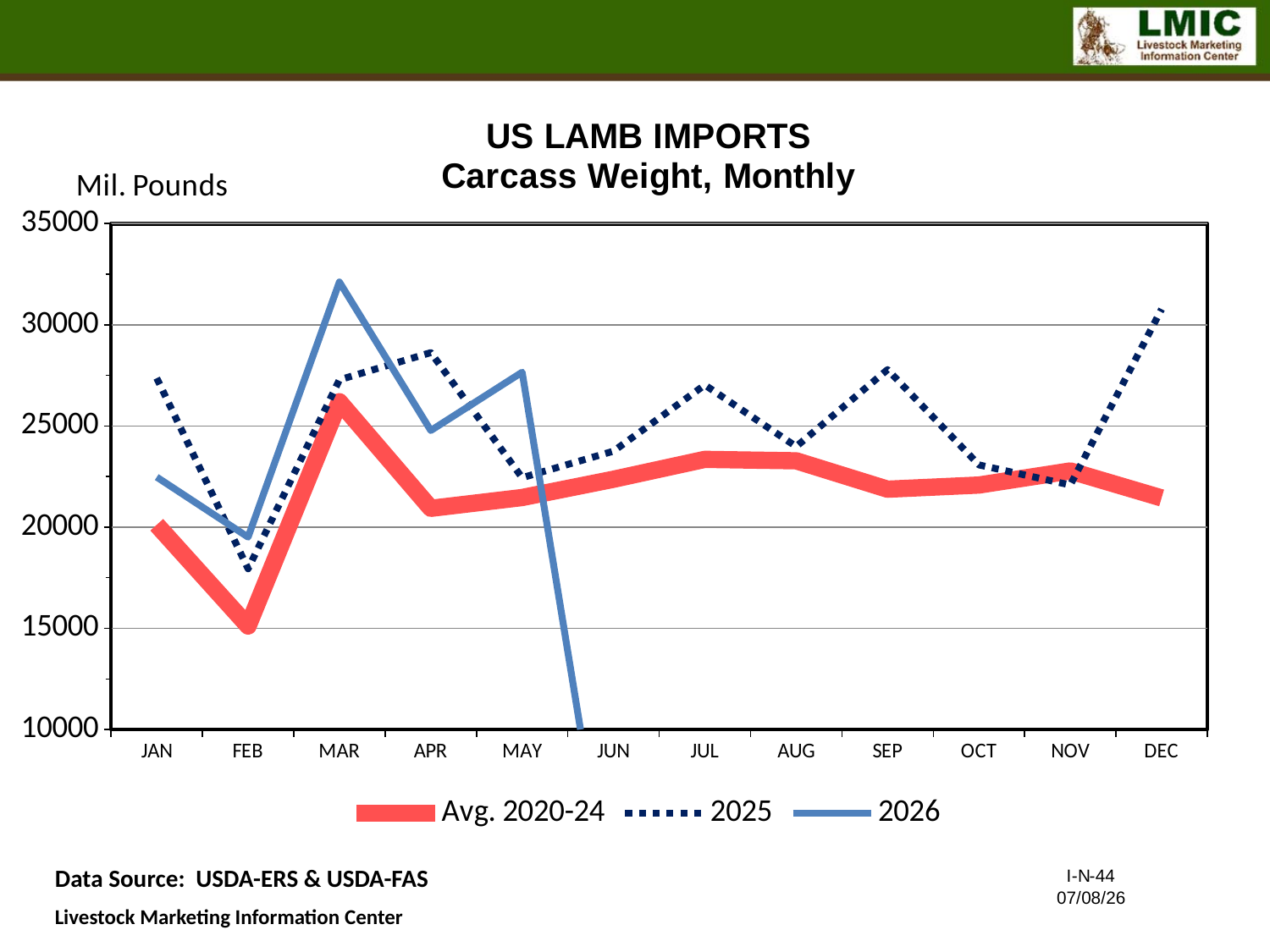
Does the Avg. 2020-24 series rise or fall from JAN to FEB? fall Is the value for Avg. 2020-24 in FEB greater or less than 20000? less Is the value for 2025 in FEB greater or less than 20000? less Is the value for 2026 in MAR greater or less than 30000? greater How many months are shown along the x axis? 12 In which month does the 2026 series reach its highest value? MAR In which month is the Avg. 2020-24 series at its lowest? FEB In APR, which series has the higher value, 2025 or 2026? 2025 What kind of chart is shown on the slide? line chart What unit label is shown above the y axis? Mil. Pounds How many series does the legend list? 3 In which month does the 2025 series reach its highest value? DEC